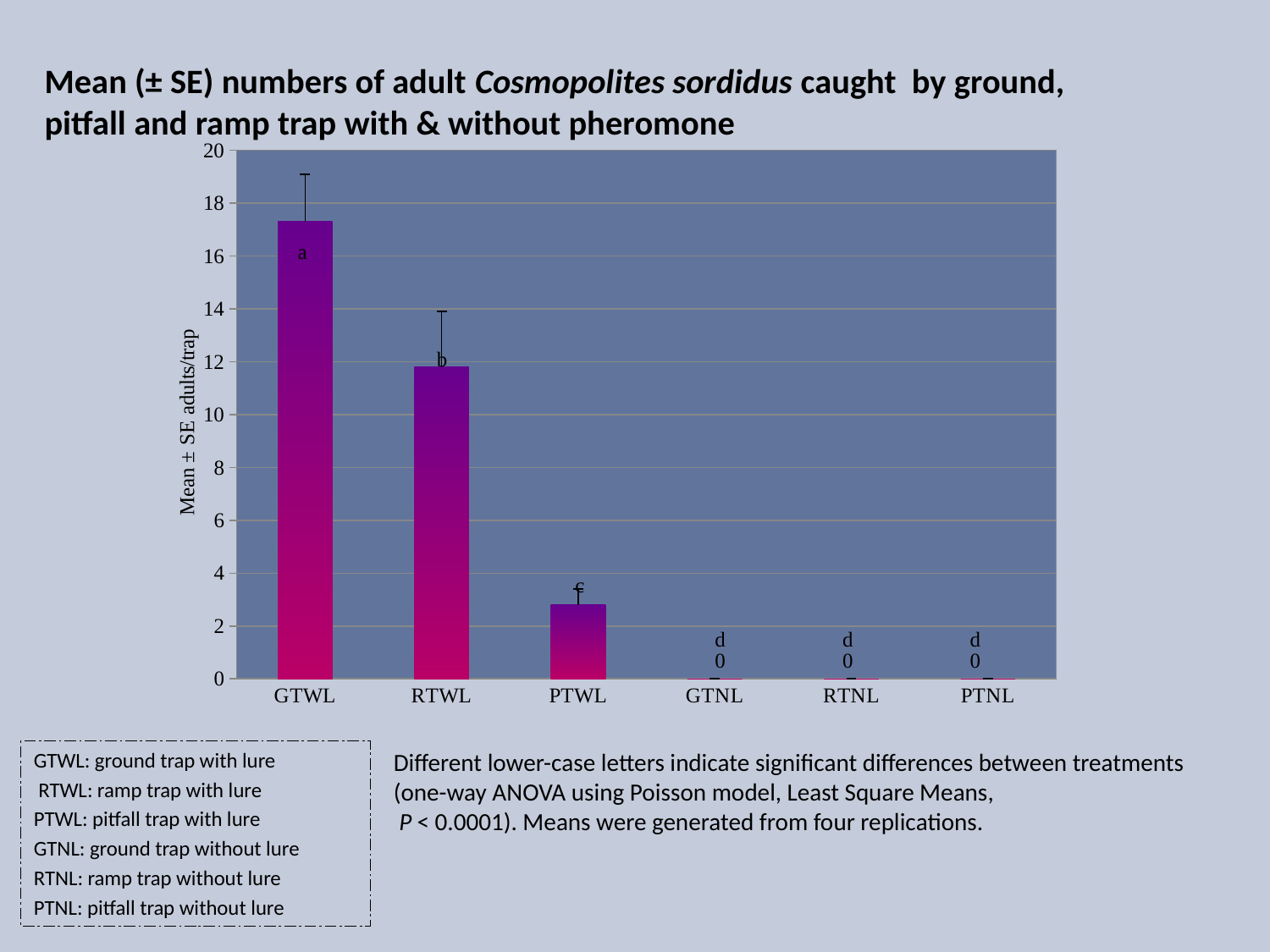
Which is larger, the value for GTWL or the value for RTWL? GTWL Is the value for GTWL greater or less than 16? greater Do the bar values rise or fall moving from GTWL to PTNL along the x axis? fall How many trap categories are shown on the x axis? 6 What kind of chart is shown on the slide? bar chart Which significance letter is printed on the GTWL bar? a Is the value for PTWL greater or less than 4? less What is the value printed for PTNL? 0 What is the label on the y axis? Mean ± SE adults/trap What is the value printed for GTNL? 0 Which trap category has the highest mean number of adults per trap? GTWL Is the value for RTWL greater or less than 10? greater